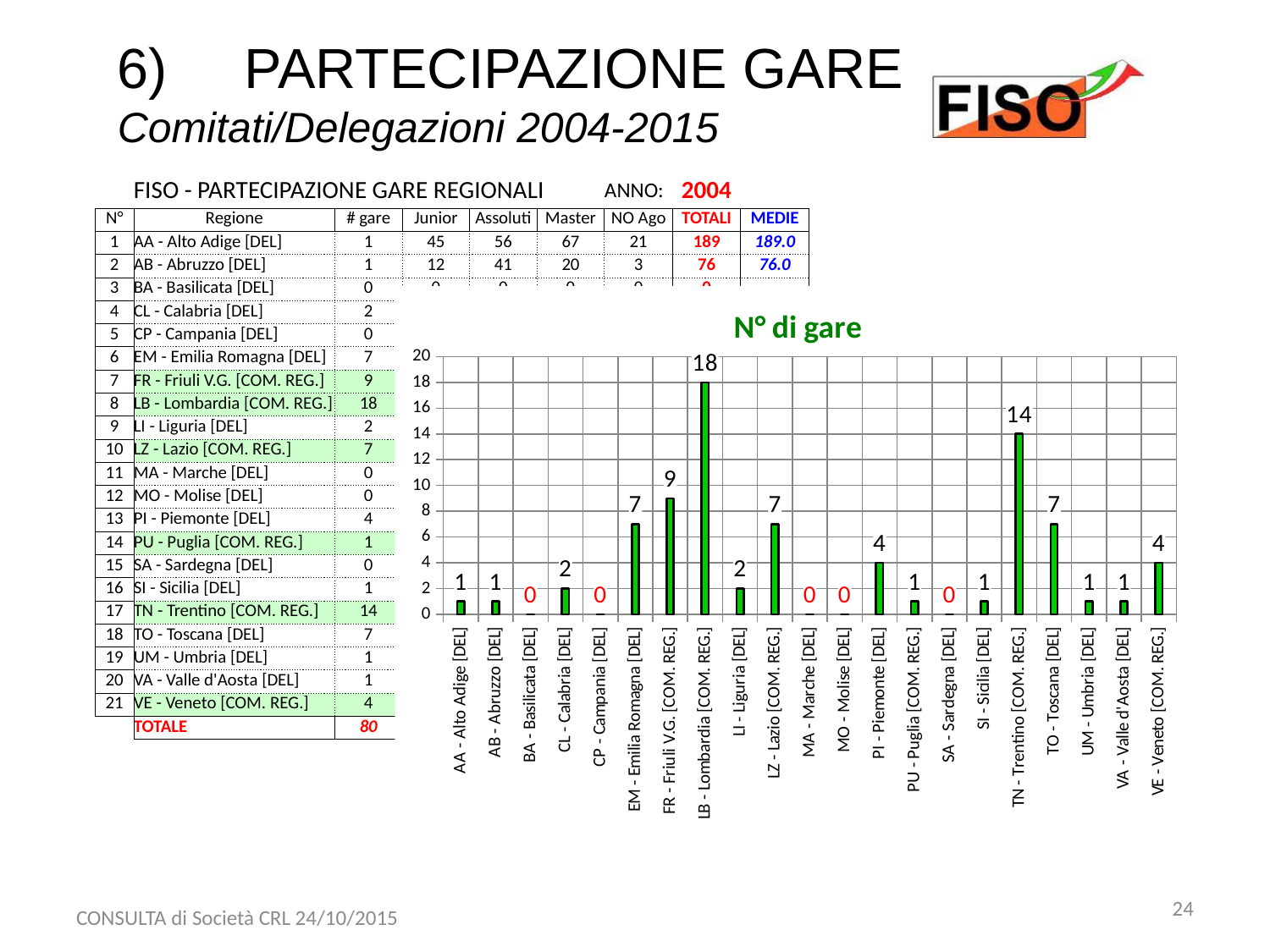
What is the value for VE - Veneto [COM. REG.] in the chart? 4 What is the value for LB - Lombardia [COM. REG.] in the chart? 18 What is the value for TN - Trentino [COM. REG.] in the chart? 14 Is the value for TN - Trentino [COM. REG.] greater or less than 10? greater What is the title of the chart on the slide? N° di gare Which region has the highest value in the chart? LB - Lombardia [COM. REG.] How many categories (regions) are plotted in the chart? 21 What is the value for FR - Friuli V.G. [COM. REG.] in the chart? 9 What is the value for PI - Piemonte [DEL] in the chart? 4 Which has a larger value, FR - Friuli V.G. [COM. REG.] or EM - Emilia Romagna [DEL]? FR - Friuli V.G. [COM. REG.] What kind of chart is shown on the slide? bar chart What is the difference between the values for LB - Lombardia [COM. REG.] and TN - Trentino [COM. REG.]? 4